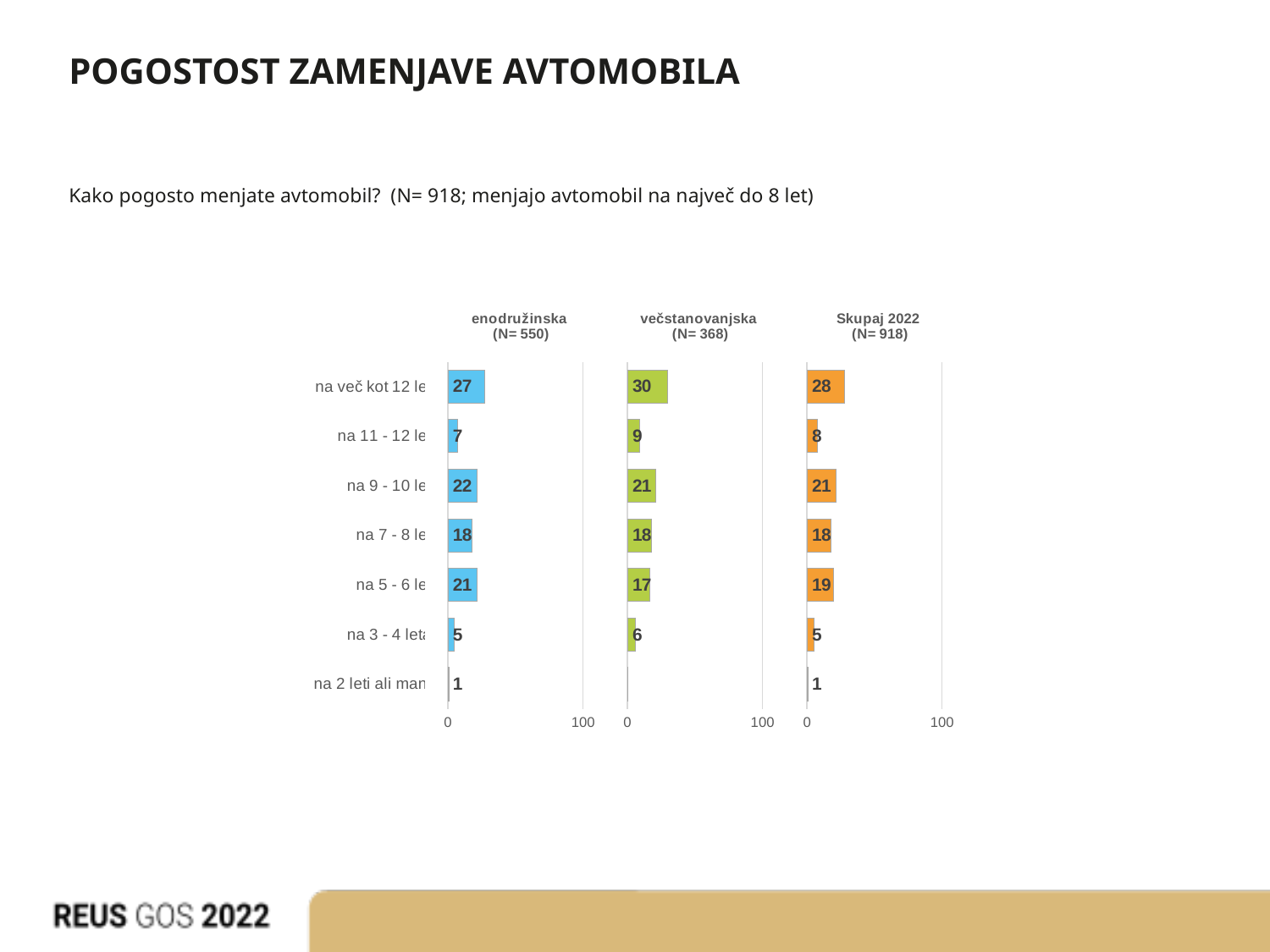
In the enodružinska (N= 550) chart, what is the difference between the values for 'na 9 - 10 le...' and 'na 11 - 12 le...'? 15 In the Skupaj 2022 (N= 918) chart, what is the value for the 'na 5 - 6 le...' category? 19 In the večstanovanjska (N= 368) chart, what is the value for the 'na 9 - 10 le...' category? 21 What kind of chart is the Skupaj 2022 (N= 918) chart? bar chart In the Skupaj 2022 (N= 918) chart, what is the difference between the values for 'na več kot 12 le...' and 'na 9 - 10 le...'? 7 In the večstanovanjska (N= 368) chart, which category has the highest value? na več kot 12 le... What colour are the bars in the večstanovanjska (N= 368) chart? green In the enodružinska (N= 550) chart, which category has the lowest value? na 2 leti ali man... How many categories are shown in the enodružinska (N= 550) chart? 7 In the enodružinska (N= 550) chart, what is the value for the 'na več kot 12 le...' category? 27 Which is larger: the 'na 5 - 6 le...' value in the enodružinska (N= 550) chart or in the večstanovanjska (N= 368) chart? enodružinska (N= 550) In the Skupaj 2022 (N= 918) chart, is the value for 'na 7 - 8 le...' greater or less than 100? less